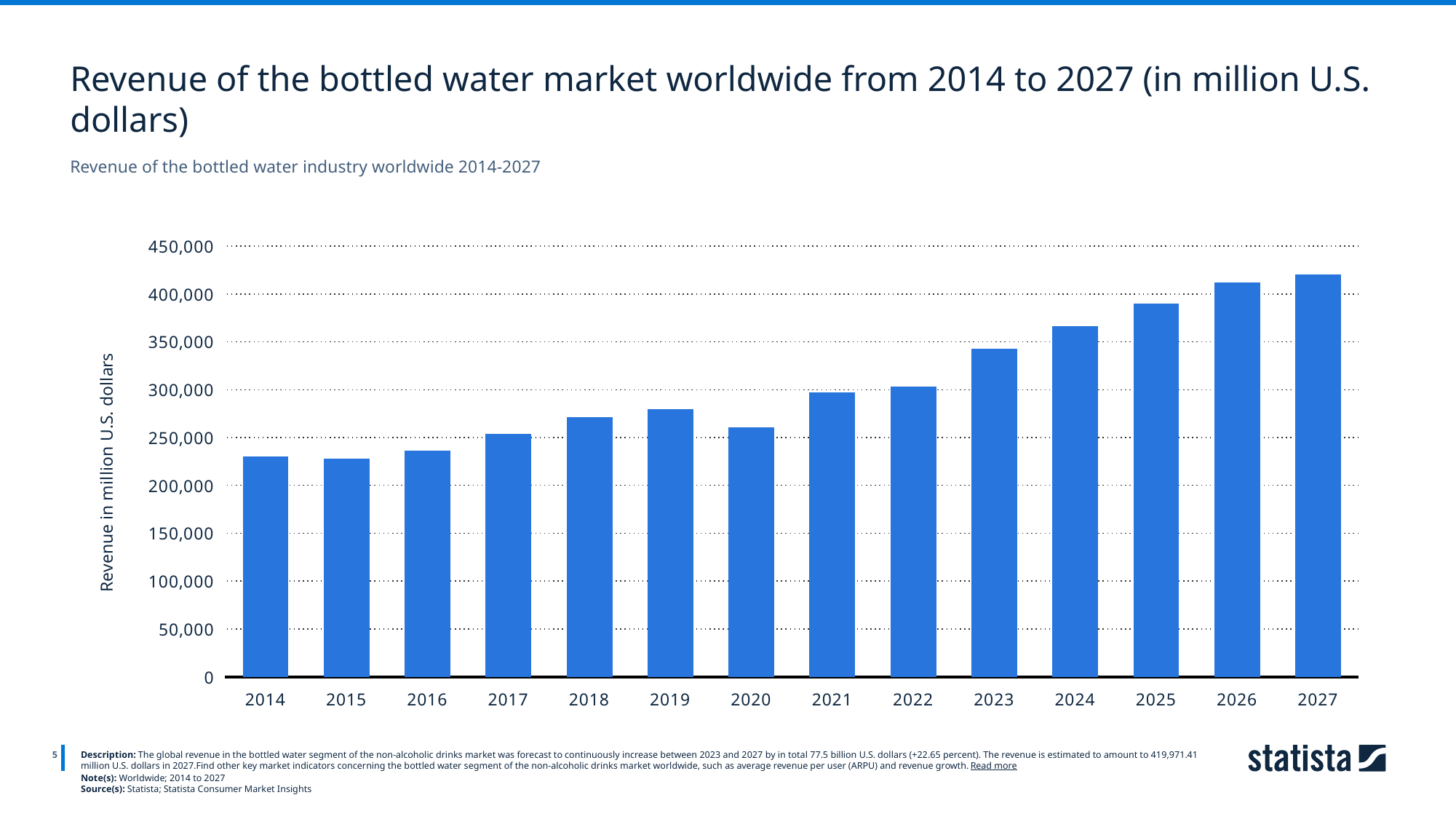
Which year has the larger revenue, 2019 or 2020? 2019 Do the revenue values generally rise or fall from 2014 to 2027? Rise Is the value for 2023 greater or less than 350,000? less Is the value for 2025 greater or less than 400,000? less Is the value for 2014 greater or less than 250,000? less What kind of chart is shown on the slide? Bar chart How many years are shown on the x axis of the chart? 14 Which year has the highest revenue in the chart? 2027 What is the label on the y axis of the chart? Revenue in million U.S. dollars